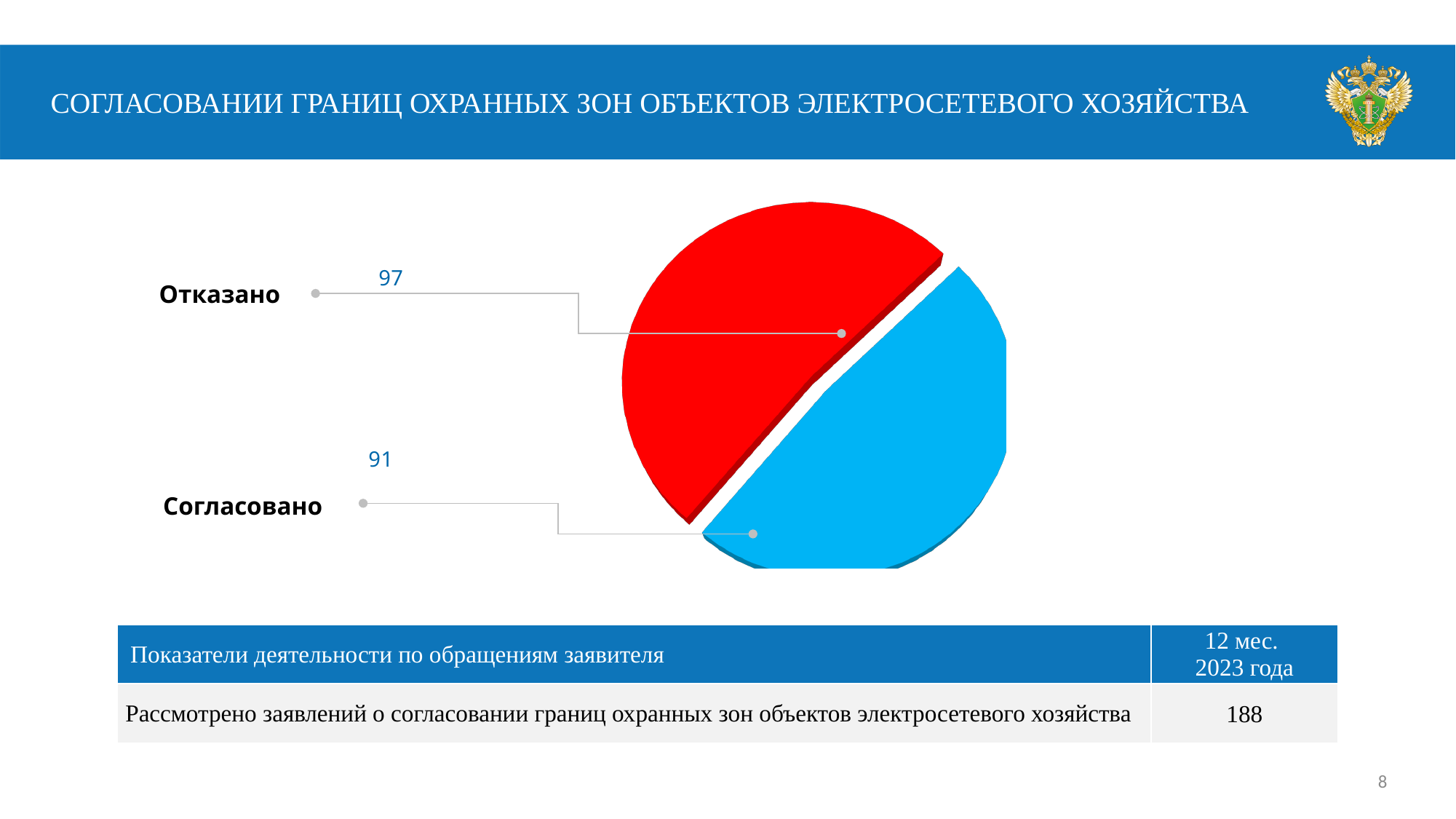
Which category has the smallest slice in the pie chart? Согласовано What share of the pie does the Отказано slice represent? 51.6% What colour is the Отказано slice in the pie chart? red Which category has the largest slice in the pie chart? Отказано What type of chart is shown on the slide? pie chart How many slices does the pie chart have? 2 What is the difference between the values for Отказано and Согласовано? 6 What colour is the Согласовано slice in the pie chart? blue What is the total of the two slices in the pie chart? 188 Which is larger, the value for Отказано or the value for Согласовано? Отказано What is the value for Отказано in the pie chart? 97 What is the value for Согласовано in the pie chart? 91